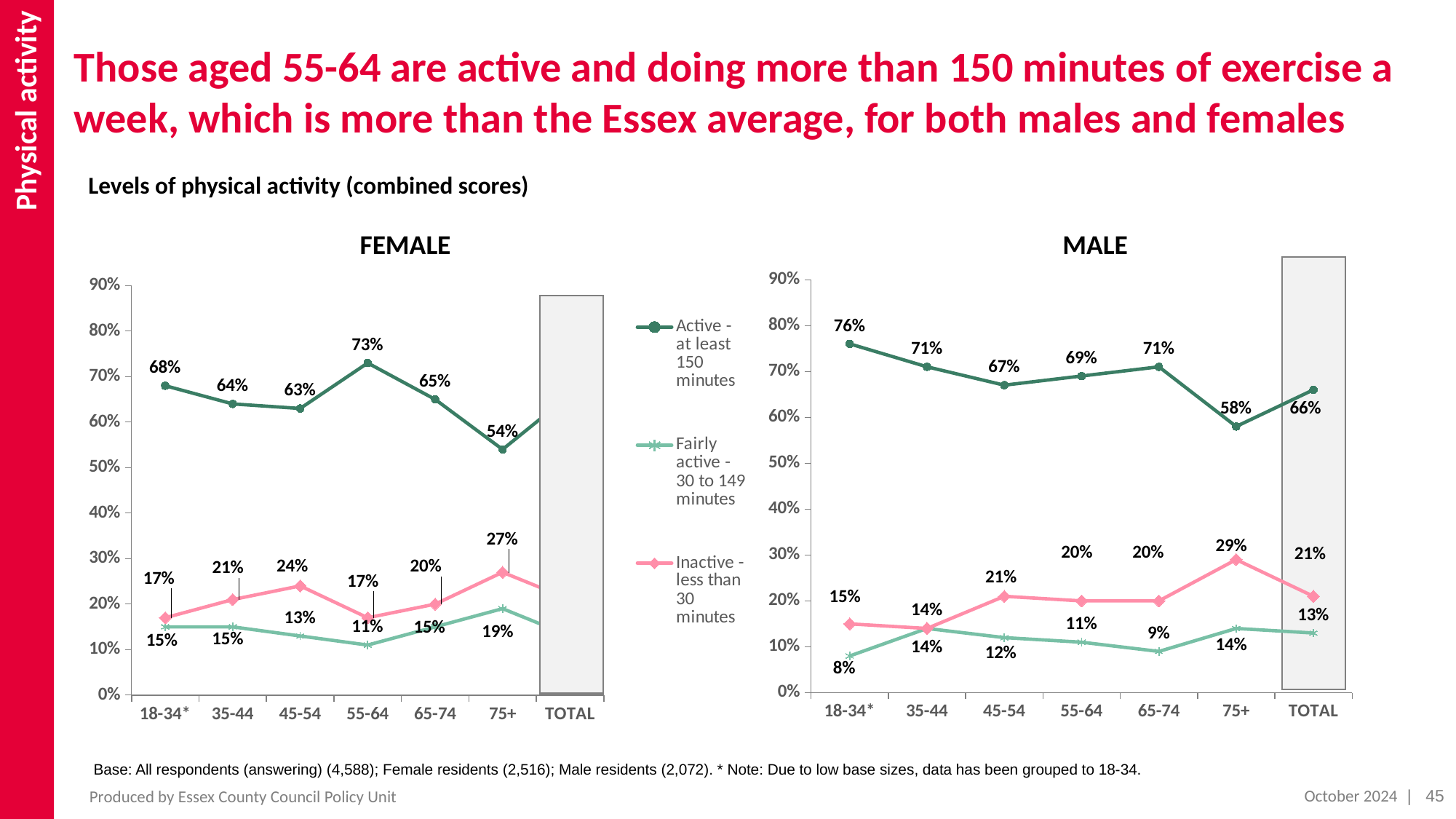
On the FEMALE chart, what percentage of those aged 55-64 are Active - at least 150 minutes? 73% What kind of chart is the MALE chart? line chart On the FEMALE chart, what is the difference between the Active - at least 150 minutes values for 55-64 and 75+? 19 percentage points On the MALE chart, does the Active - at least 150 minutes line rise or fall from 18-34* to 45-54? fall On the MALE chart, which age group has the lowest value for Active - at least 150 minutes? 75+ On the FEMALE chart, what percentage of those aged 55-64 are Fairly active - 30 to 149 minutes? 11% On the FEMALE chart, which age group has the highest value for Active - at least 150 minutes? 55-64 On the MALE chart, which is larger for those aged 45-54: Inactive - less than 30 minutes or Fairly active - 30 to 149 minutes? Inactive - less than 30 minutes How many series does the legend list? 3 On the FEMALE chart, is the TOTAL value for Active - at least 150 minutes greater or less than 50%? greater On the MALE chart, what is the TOTAL value for Inactive - less than 30 minutes? 21% On the MALE chart, what percentage of those aged 18-34* are Active - at least 150 minutes? 76%